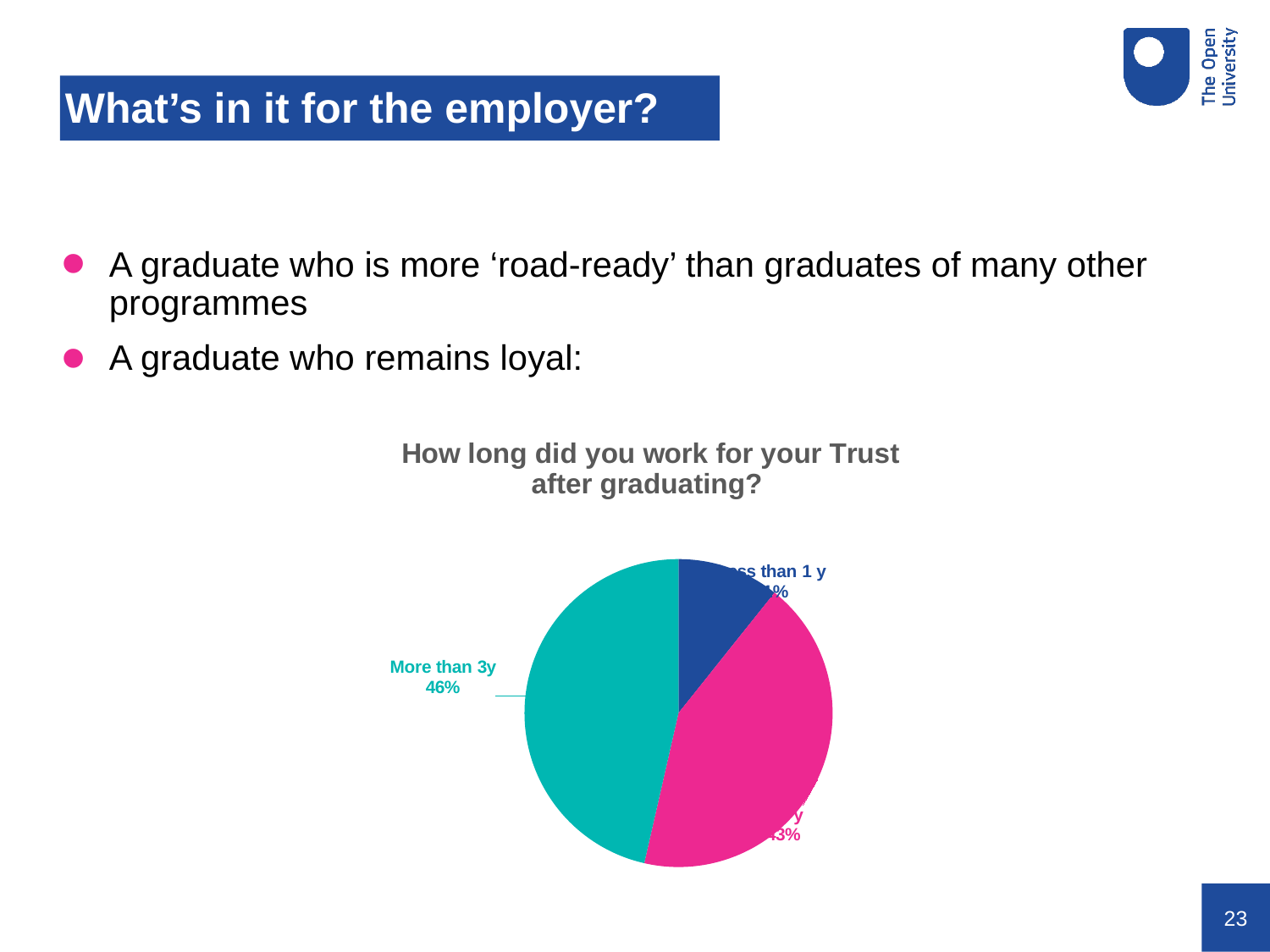
What is the title of the chart? How long did you work for your Trust after graduating? What percentage of respondents worked for their Trust for more than 3 years after graduating? 46% Which category has the smallest share of the pie? Less than 1 y What kind of chart is shown on the slide? Pie chart What colour is the 'More than 3y' slice? Teal Which is larger: the share for 'More than 3y' or the share for 'Less than 1 y'? More than 3y Which category has the largest share of the pie? More than 3y How many slices does the pie chart have? 3 What share of the pie does the 'More than 3y' slice represent? 46%